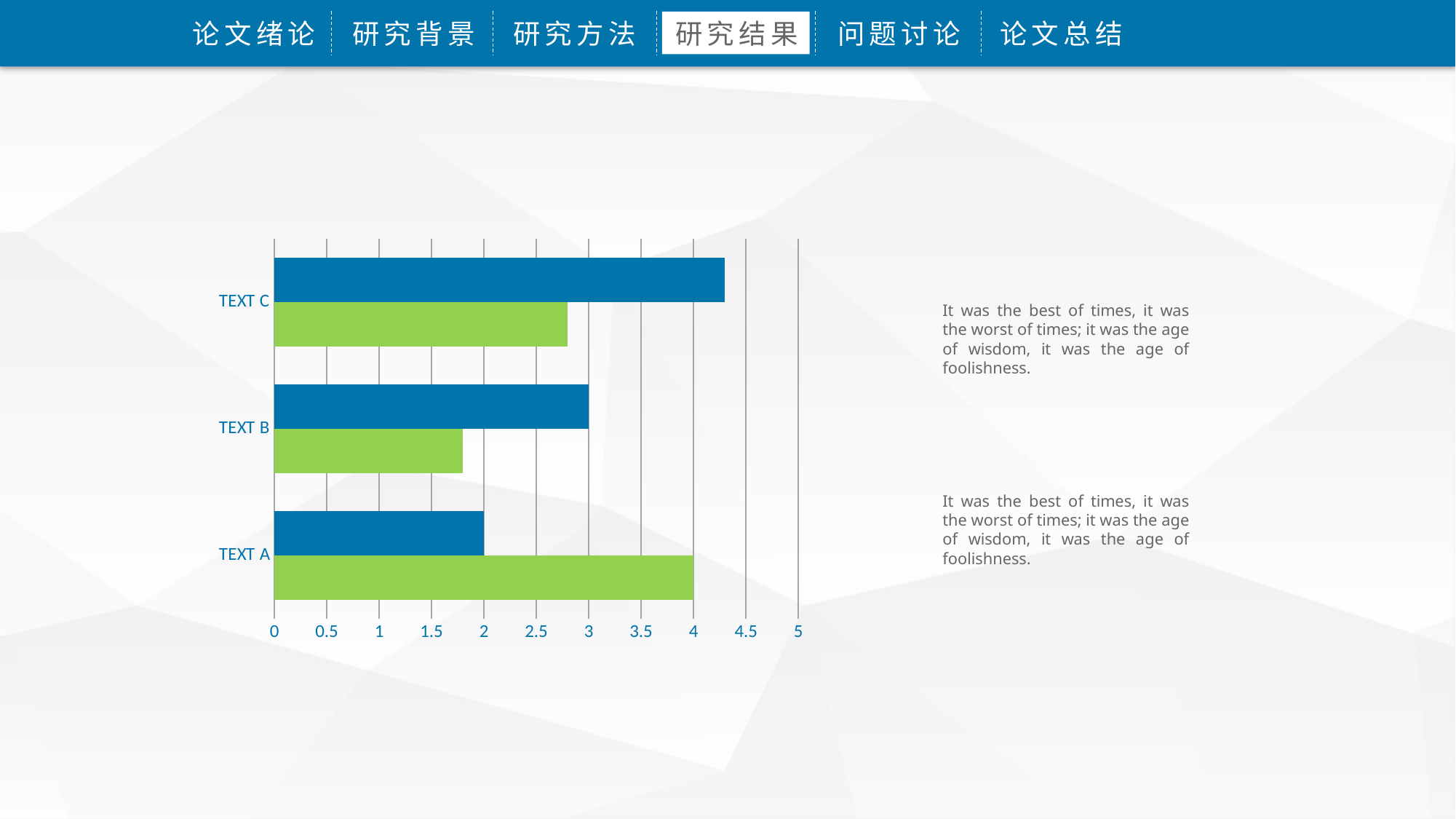
For TEXT A, which bar is larger, the blue one or the green one? green What kind of chart is shown on the slide? bar chart How many categories are shown on the chart? 3 Is the value of the green bar for TEXT C greater or less than 3? less Which category has the longest blue bar? TEXT C What is the value of the green bar for TEXT A? 4 What is the difference between the green bar and the blue bar for TEXT A? 2 Is the value of the blue bar for TEXT C greater or less than 4? greater What is the value of the blue bar for TEXT B? 3 What is the value of the blue bar for TEXT A? 2 Is the value of the green bar for TEXT B greater or less than 2? less Which category has the shortest green bar? TEXT B